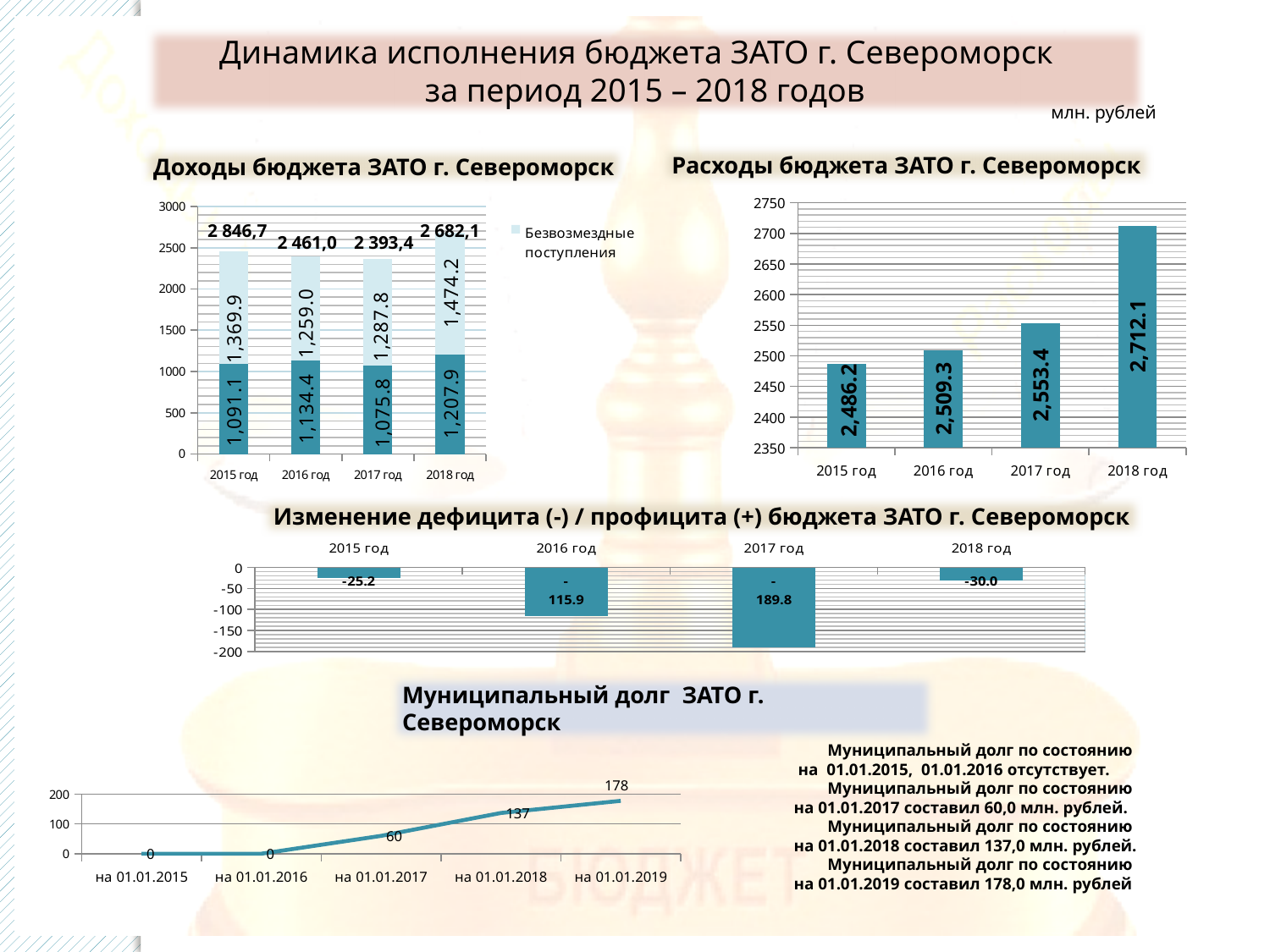
What kind of chart is 'Муниципальный долг ЗАТО г. Североморск'? line chart In the chart 'Муниципальный долг ЗАТО г. Североморск', what is the value on 01.01.2018? 137 In the chart 'Изменение дефицита (-) / профицита (+) бюджета ЗАТО г. Североморск', what is the value for 2016 год? -115.9 In the chart 'Расходы бюджета ЗАТО г. Североморск', which year has the highest value? 2018 год In the chart 'Расходы бюджета ЗАТО г. Североморск', what is the value for 2018 год? 2,712.1 In the chart 'Доходы бюджета ЗАТО г. Североморск', what is the value of 'Безвозмездные поступления' for 2018 год? 1,474.2 In the chart 'Доходы бюджета ЗАТО г. Североморск', what is the value of the bottom (dark) segment for 2017 год? 1,075.8 In the chart 'Расходы бюджета ЗАТО г. Североморск', which year has the lowest value? 2015 год In the chart 'Доходы бюджета ЗАТО г. Североморск', how many years are shown on the x axis? 4 In the chart 'Расходы бюджета ЗАТО г. Североморск', what is the difference between the values for 2018 год and 2017 год? 158.7 In the chart 'Изменение дефицита (-) / профицита (+) бюджета ЗАТО г. Североморск', which year has the lowest value? 2017 год In the chart 'Муниципальный долг ЗАТО г. Североморск', do the values rise or fall from 01.01.2016 to 01.01.2019? rise